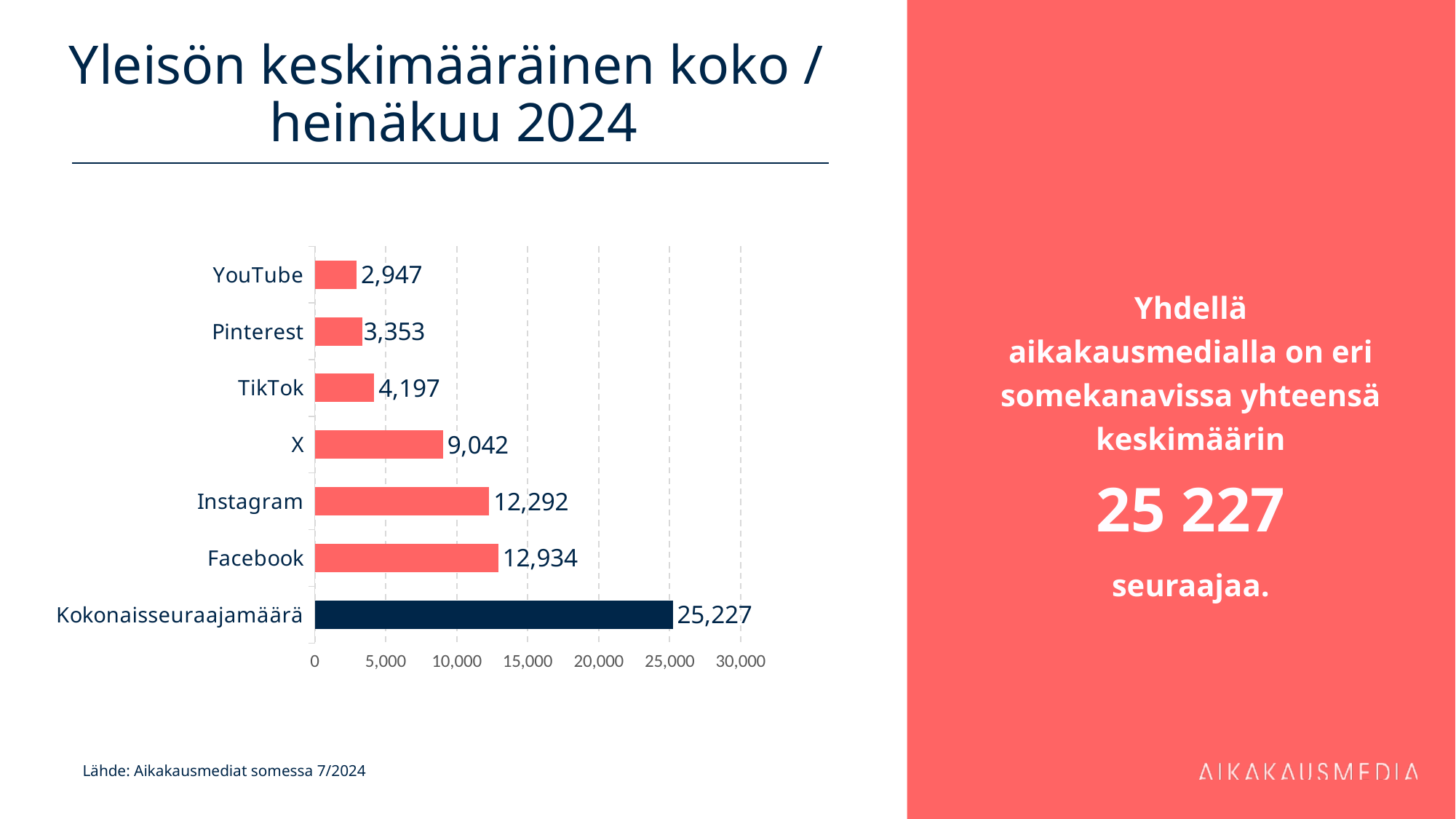
Which bar is shown in a different colour (dark navy) from the others? Kokonaisseuraajamäärä What is the value for Kokonaisseuraajamäärä? 25,227 Is the value for X greater or less than 10,000? less How many categories are shown in the chart? 7 What is the value for TikTok? 4,197 What is the value for Facebook? 12,934 Which is larger, the value for Pinterest or the value for YouTube? Pinterest What kind of chart is shown on the slide? bar chart Which category has the highest value? Kokonaisseuraajamäärä What is the difference between the values for X and TikTok? 4,845 Which category has the lowest value? YouTube What is the difference between the values for Facebook and Instagram? 642